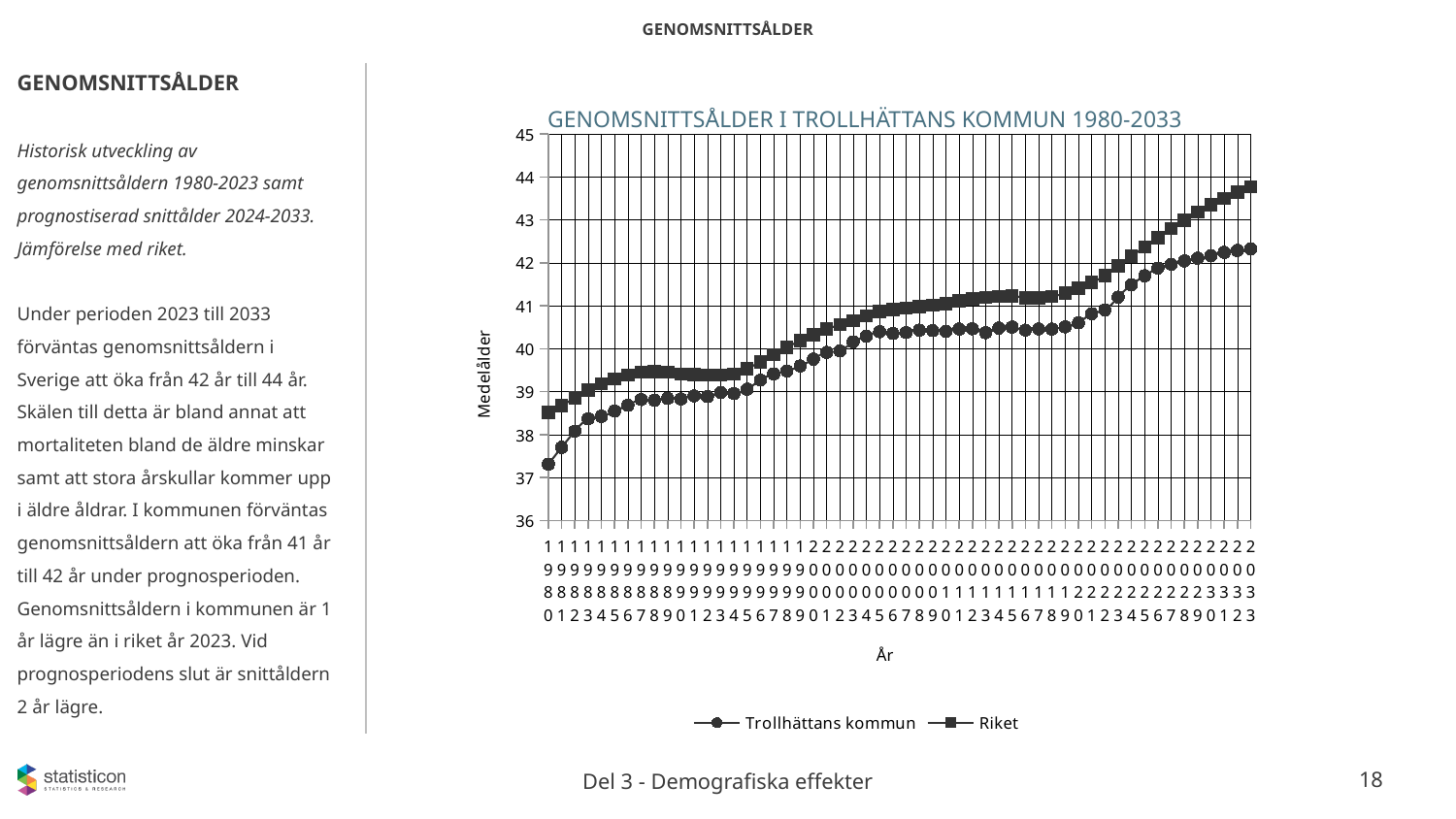
What is the title of the chart? GENOMSNITTSÅLDER I TROLLHÄTTANS KOMMUN 1980-2033 What kind of chart is shown on the slide? Line chart What are the two series named in the chart legend? Trollhättans kommun and Riket Is the value for Riket in 1980 greater or less than 38? greater Do the values for Trollhättans kommun generally rise or fall from 1980 to 2033? Rise Is the value for Trollhättans kommun in 2023 greater or less than 41? greater Is the value for Riket in 2033 greater or less than 43? greater How many years (data points per series) are plotted on the x axis? 54 How many series does the chart legend list? 2 Which series has the higher value in 2033, Trollhättans kommun or Riket? Riket